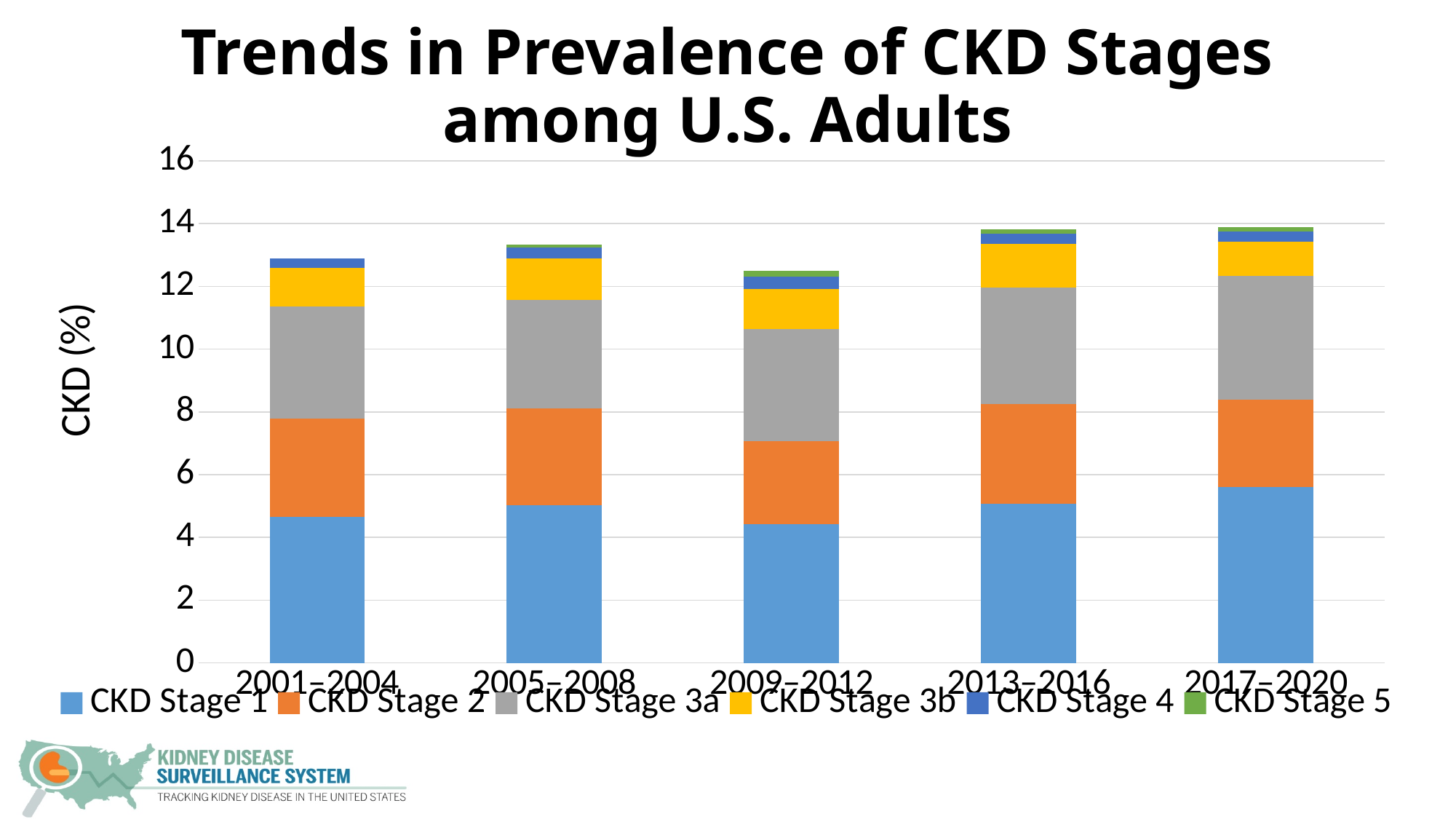
Which time period has the lowest total CKD prevalence? 2009–2012 Is the total CKD prevalence for 2013–2016 greater or less than 12? greater Which time period has the largest CKD Stage 1 segment? 2017–2020 Is the CKD Stage 1 value for 2017–2020 greater or less than 4? greater What is the label on the y axis? CKD (%) Which has the larger total CKD prevalence, 2009–2012 or 2013–2016? 2013–2016 Is the total CKD prevalence for 2009–2012 greater or less than 14? less Which has the larger CKD Stage 1 value, 2001–2004 or 2017–2020? 2017–2020 What kind of chart is shown on the slide? Stacked bar chart How many time periods are shown on the x axis? 5 What is the title of the chart? Trends in Prevalence of CKD Stages among U.S. Adults How many series does the legend list? 6